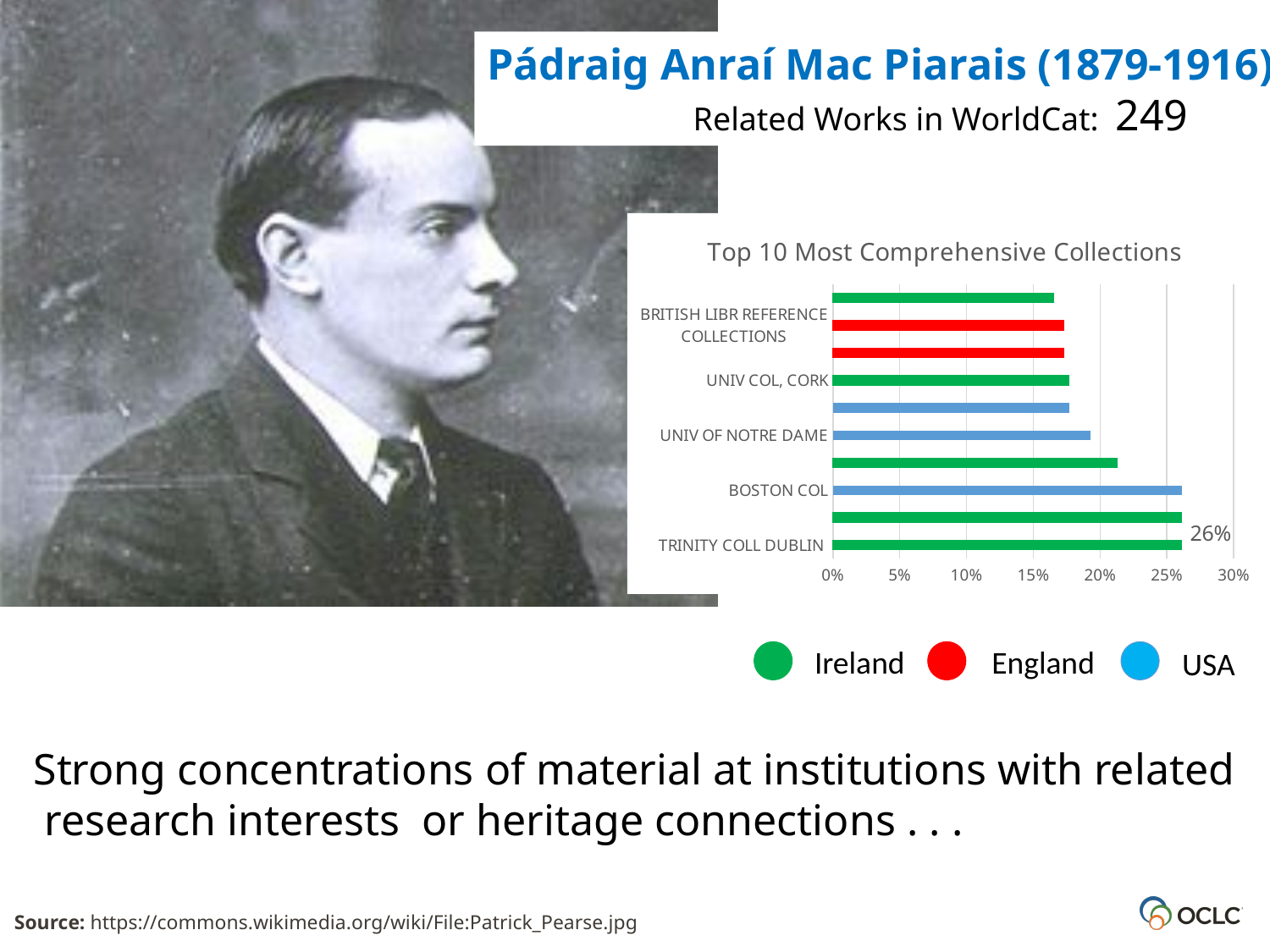
What is the title of the chart? Top 10 Most Comprehensive Collections How many series does the chart legend list? 3 Is the value for UNIV OF NOTRE DAME greater or less than 25%? less Is the value for UNIV COL, CORK greater or less than 20%? less Which colour represents USA in the chart legend? blue Is the value for BRITISH LIBR REFERENCE COLLECTIONS greater or less than 15%? greater What kind of chart is shown on the slide? bar chart How many bars are plotted in the chart? 10 Which has the larger value, BOSTON COL or UNIV OF NOTRE DAME? BOSTON COL Which has the larger value, TRINITY COLL DUBLIN or UNIV COL, CORK? TRINITY COLL DUBLIN What is the value shown for TRINITY COLL DUBLIN? 26%